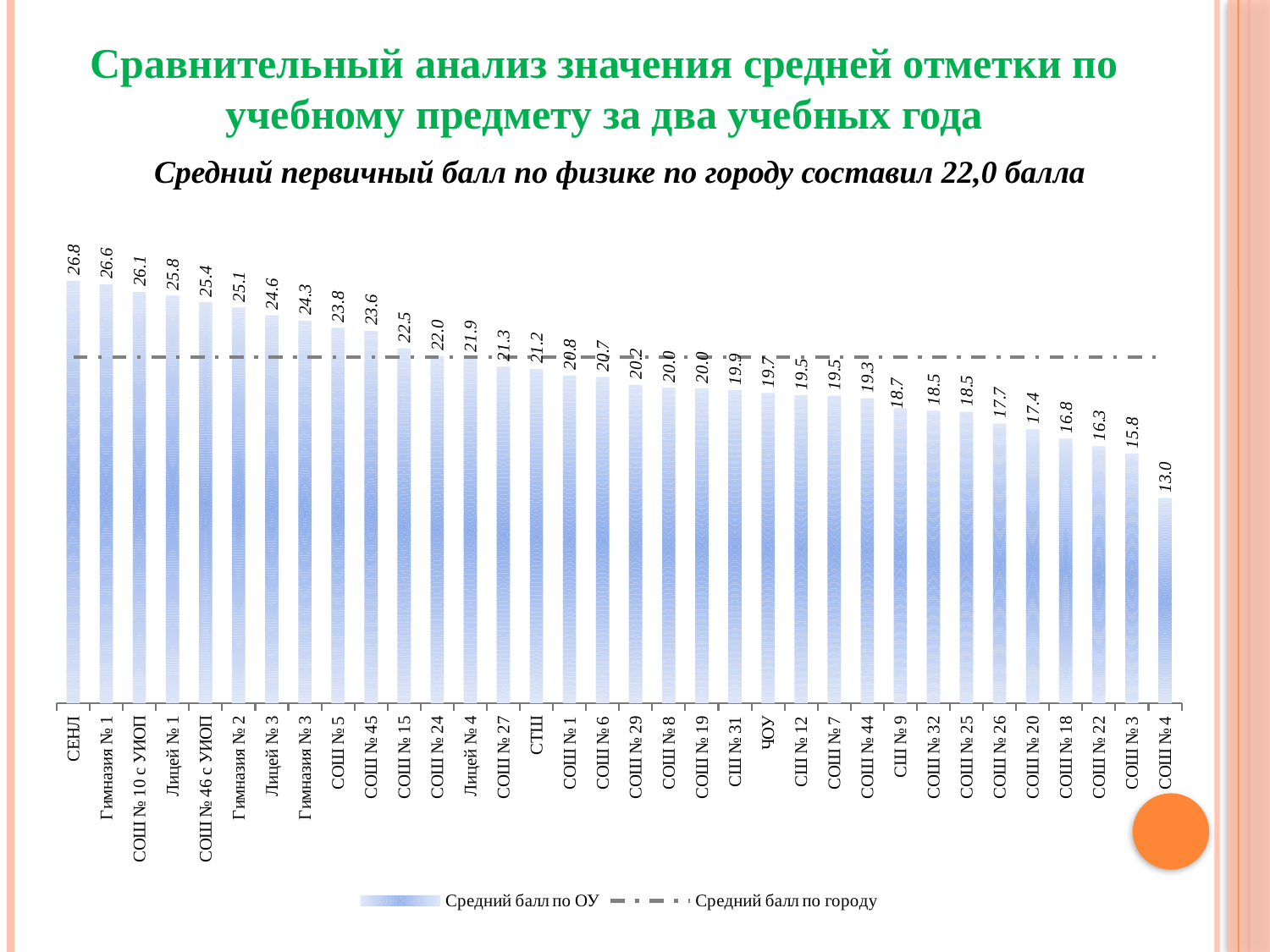
What does the dashed horizontal line represent according to the legend? Средний балл по городу Which school has the highest average score? СЕНЛ What is the difference between the values for Гимназия № 1 and СОШ № 3? 10.8 Do the bar values rise or fall from left to right? fall What is the value for СОШ № 45? 23.6 Which is larger, the value for Лицей № 4 or the value for СОШ № 26? Лицей № 4 How many entries does the legend list? 2 What kind of chart is this? bar chart What is the value for СЕНЛ? 26.8 How many schools are shown on the chart? 34 What is the value for СОШ № 4? 13.0 Which school has the lowest average score? СОШ № 4